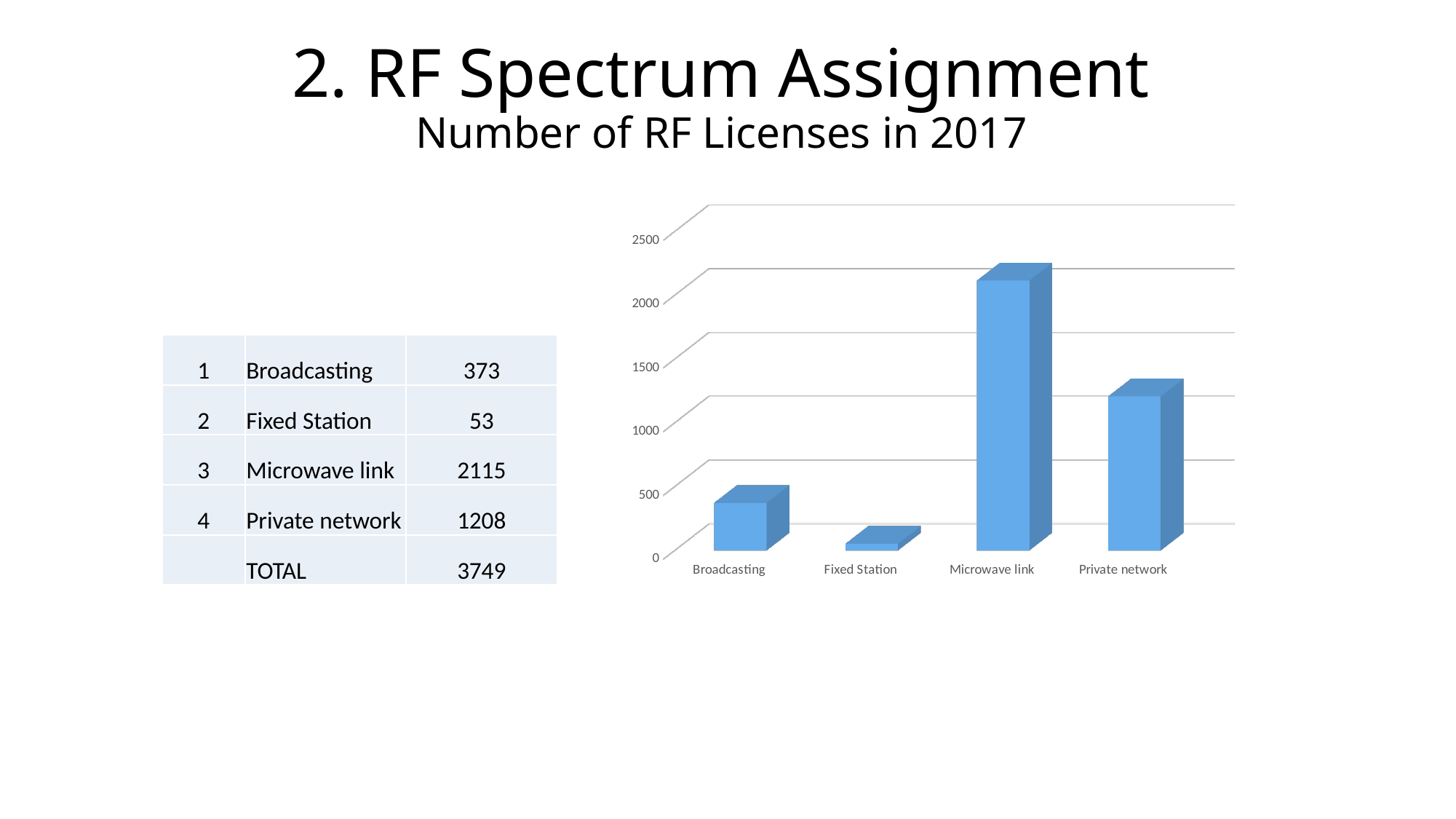
According to the slide, what is the number of RF licenses for Microwave link? 2115 Which category has the lowest bar in the chart? Fixed Station How many categories does the bar chart show? 4 What is the highest value labelled on the chart's vertical axis? 2500 Is the value for Microwave link greater or less than 2000? greater What is the difference between the number of licenses for Microwave link and Private network, as printed on the slide? 907 Is the value for Broadcasting greater or less than 500? less What kind of chart is shown on the slide? bar chart Is the value for Private network greater or less than 1000? greater Which is larger, the bar for Private network or the bar for Broadcasting? Private network Which category has the highest bar in the chart? Microwave link According to the slide, what is the number of RF licenses for Fixed Station? 53